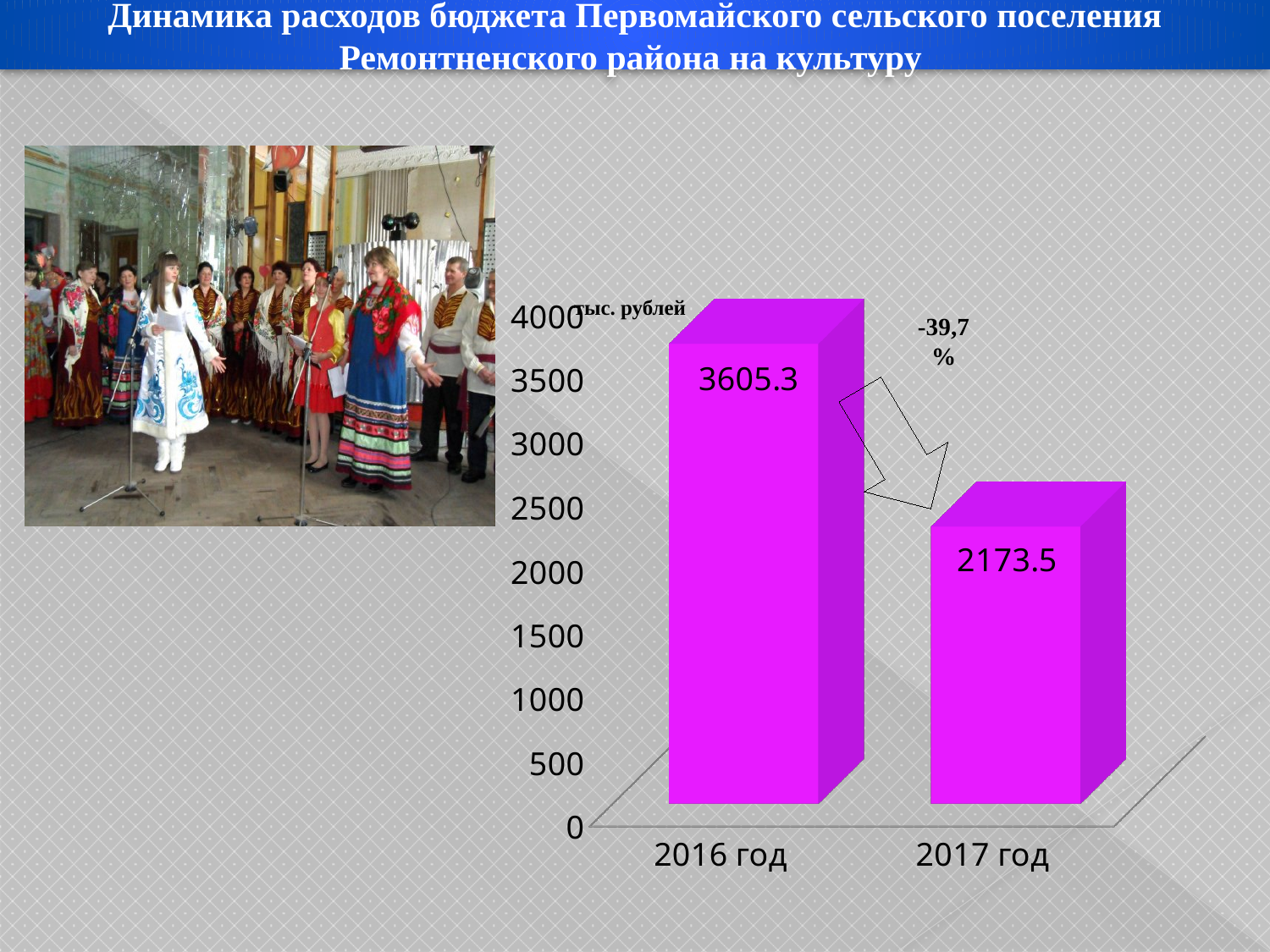
Which year has the lowest value? 2017 год What percentage change is annotated next to the arrow between the bars? -39,7 % How many categories are shown on the chart? 2 Do the values rise or fall from 2016 год to 2017 год? fall What kind of chart is shown on the slide? bar chart What is the value for 2017 год? 2173.5 Which year has the highest value? 2016 год What is the value for 2016 год? 3605.3 Is the value for 2016 год greater or less than 3500? greater What is the difference between the values for 2016 год and 2017 год? 1431.8 Is the value for 2017 год greater or less than 2500? less Which is larger, the value for 2016 год or for 2017 год? 2016 год